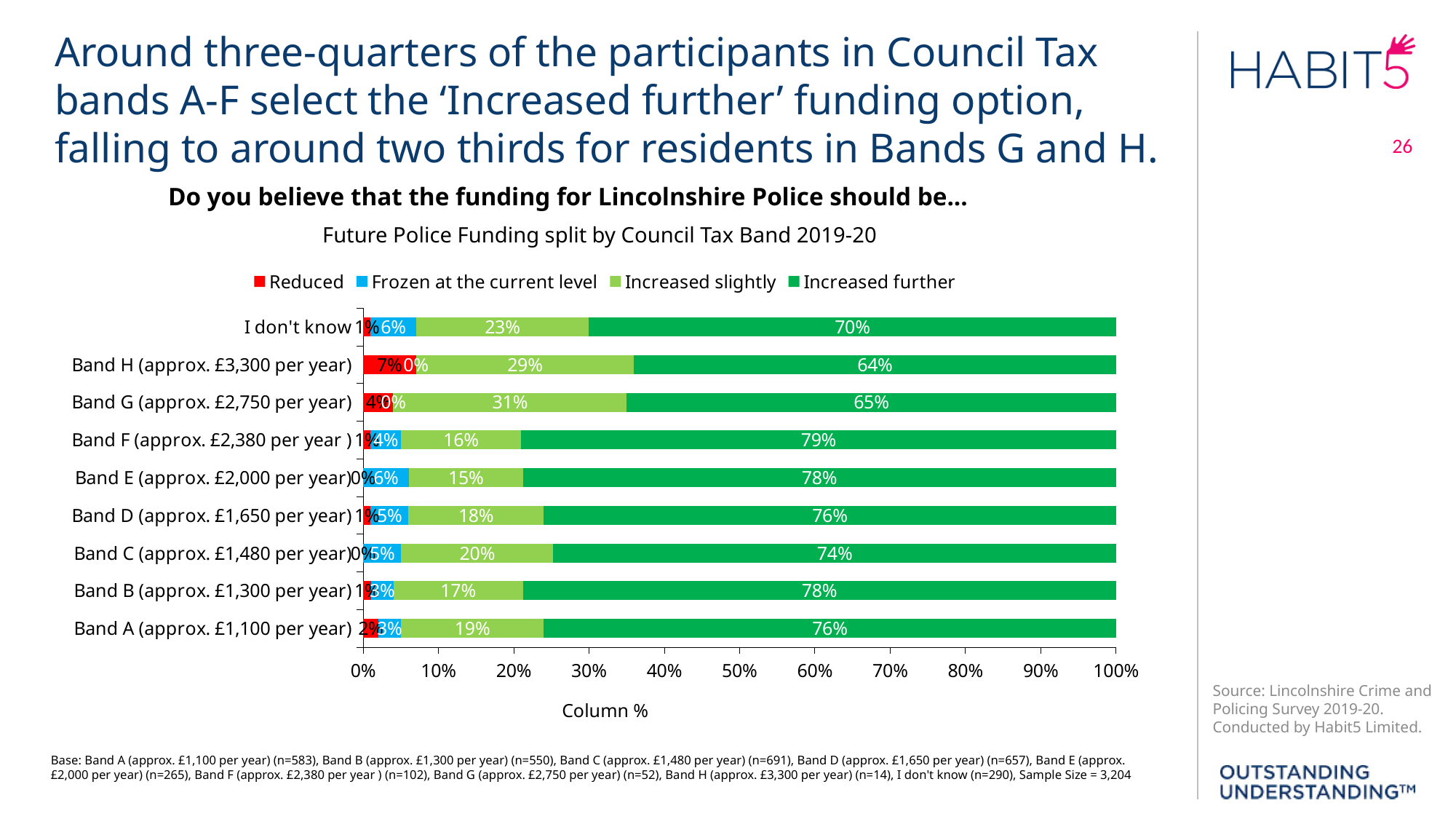
What is the 'Increased slightly' value for Band E (approx. £2,000 per year)? 15% How many series does the legend list? 4 What type of chart is shown on the slide? Stacked bar chart What percentage of Band G (approx. £2,750 per year) participants selected 'Increased slightly'? 31% What percentage of Band F (approx. £2,380 per year) participants selected 'Increased further'? 79% What is the 'Increased further' value for the 'I don't know' category? 70% Which has a larger 'Increased slightly' share: Band H or Band A? Band H (approx. £3,300 per year) Which category has the lowest 'Increased further' percentage? Band H (approx. £3,300 per year) Which council tax band has the highest 'Increased further' percentage? Band F (approx. £2,380 per year ) How many categories (bars) are shown on the chart? 9 What colour represents the 'Reduced' series in the legend? Red What is the difference in percentage points between the 'Increased further' values for Band F and Band H? 15 percentage points